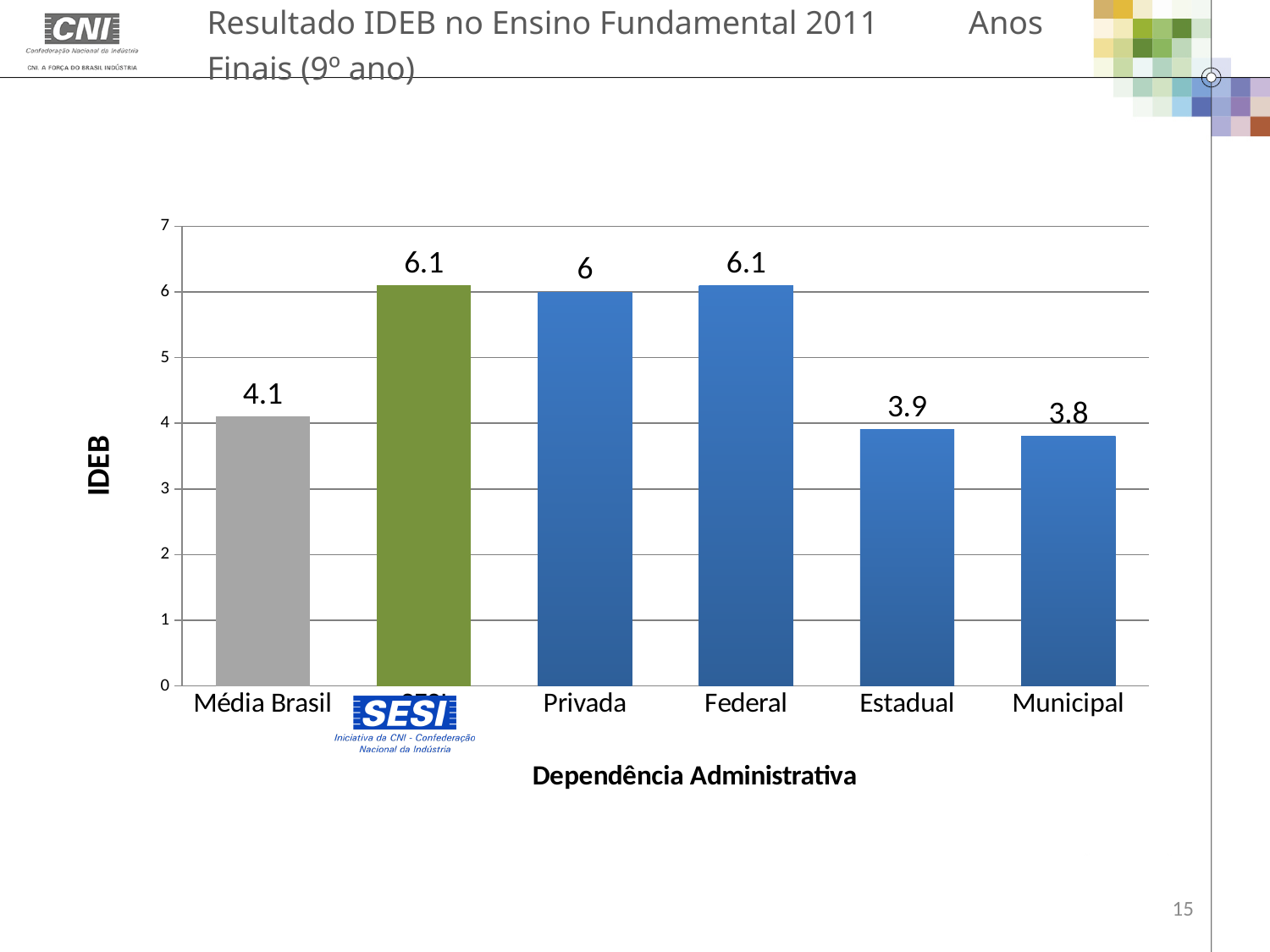
What is the IDEB value for Privada? 6 What is the difference between the IDEB values for Federal and Estadual? 2.2 What is the title of the x axis? Dependência Administrativa What kind of chart is shown on the slide? Bar chart Which category has the lowest IDEB value? Municipal What is the IDEB value for Municipal? 3.8 What is the IDEB value for Média Brasil? 4.1 Which has a higher IDEB value, Privada or Média Brasil? Privada Is the IDEB value for Privada greater or less than 5? greater How many categories are shown on the x axis? 6 What is the IDEB value for Estadual? 3.9 What is the IDEB value for Federal? 6.1